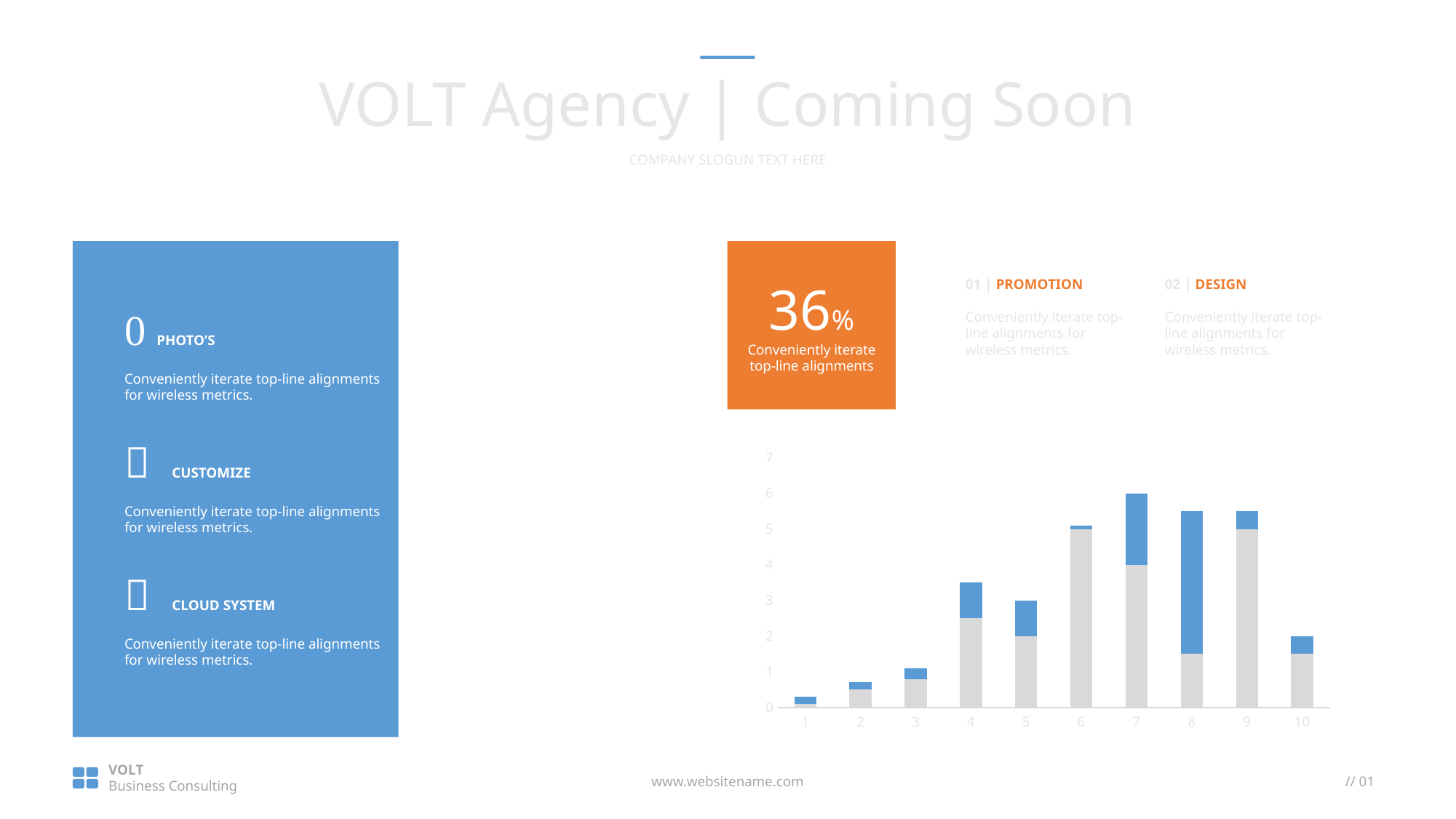
Is the total value for category 3 greater or less than 2? less Do the bar totals rise or fall from category 1 to category 7? rise Is the total value for category 6 greater or less than 4? greater Which bar is taller, category 4 or category 5? category 4 What kind of chart is shown on the slide? bar chart What is the highest value shown on the y axis of the chart? 7 What is the total height of the stacked bar for category 7? 6 Is the total value for category 8 greater or less than 5? greater Which category has the shortest bar in the chart? 1 Which category has the tallest bar in the chart? 7 What is the total height of the stacked bar for category 5? 3 How many categories are shown on the x axis of the chart? 10